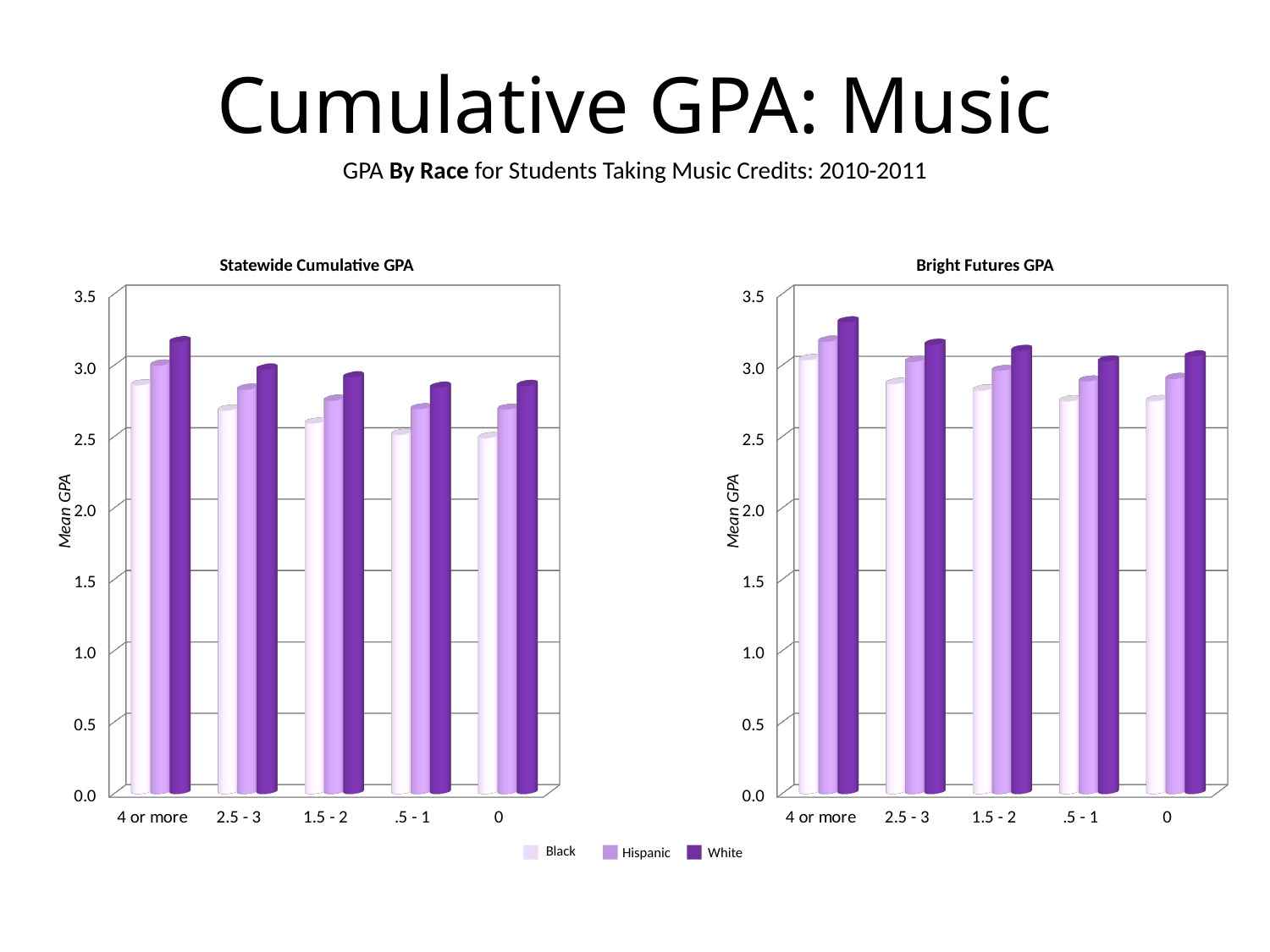
In the Bright Futures GPA chart, which category has the highest White bar? 4 or more How many categories are shown on the x axis of the Bright Futures GPA chart? 5 In the Bright Futures GPA chart, is the value for White in the "4 or more" category greater or less than 3.0? greater What is the label on the vertical axis of the Statewide Cumulative GPA chart? Mean GPA In the Statewide Cumulative GPA chart, is the value for Black in the "4 or more" category greater or less than 3.0? less How many series does the legend list for the charts? 3 In the Bright Futures GPA chart, is the value for Black in the "0" category greater or less than 3.0? less In the Statewide Cumulative GPA chart, do the Black bars rise or fall moving from "4 or more" to "0" along the x axis? fall What kind of chart is the Statewide Cumulative GPA chart? bar chart In the Bright Futures GPA chart, which is larger in the "2.5 - 3" category, Hispanic or Black? Hispanic In the Statewide Cumulative GPA chart, which series has the highest bar in the "4 or more" category? White